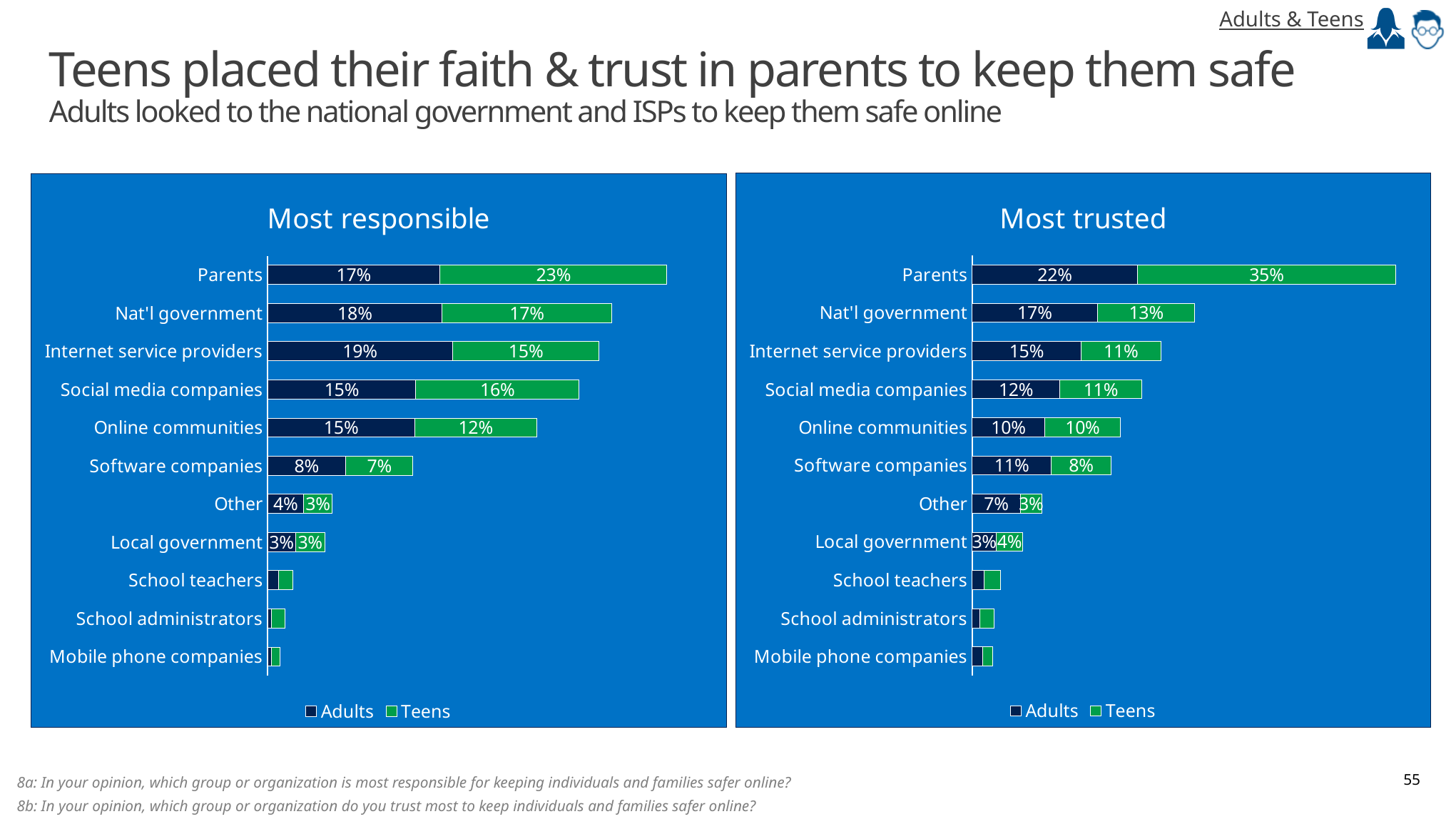
In the "Most trusted" chart, which category has the highest Teens value? Parents How many categories are shown in the "Most responsible" chart? 11 In the "Most trusted" chart, what is the total of the stacked bar for Parents? 57% What kind of chart is the "Most responsible" chart? Stacked bar chart How many series does the legend of the "Most trusted" chart list? 2 In the "Most trusted" chart, what is the total of the stacked bar for Online communities? 20% In the "Most responsible" chart, what is the Teens value for Parents? 23% In the "Most responsible" chart, which is larger for Social media companies, the Adults value or the Teens value? Teens In the "Most trusted" chart, what is the Adults value for Nat'l government? 17% In the "Most responsible" chart, what is the Adults value for Internet service providers? 19% In the "Most trusted" chart, what is the Teens value for Software companies? 8% In the "Most responsible" chart, what is the difference between the Teens and Adults values for Parents? 6%